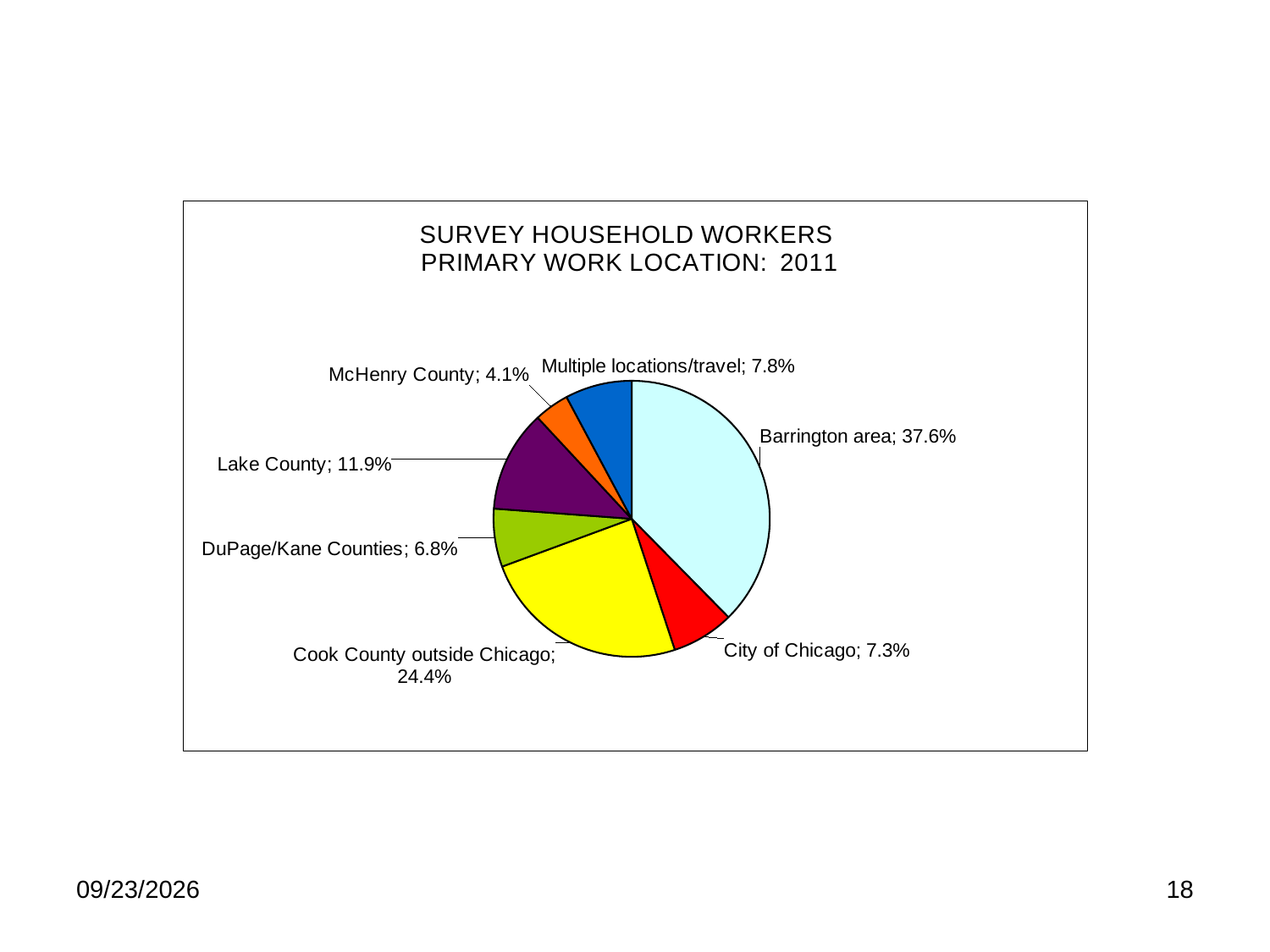
Which is larger, Multiple locations/travel or DuPage/Kane Counties? Multiple locations/travel What is the value for Lake County? 11.9% Which category has the smallest share of the pie? McHenry County How many slices does the pie chart have? 7 What is the title of the chart? SURVEY HOUSEHOLD WORKERS PRIMARY WORK LOCATION: 2011 Which category has the largest share of the pie? Barrington area What kind of chart is shown on the slide? pie chart What is the value for Cook County outside Chicago? 24.4% What is the value for City of Chicago? 7.3% What is the difference between the Barrington area and Cook County outside Chicago shares? 13.2% What share of the pie is the Barrington area? 37.6% What colour is the Cook County outside Chicago slice? yellow